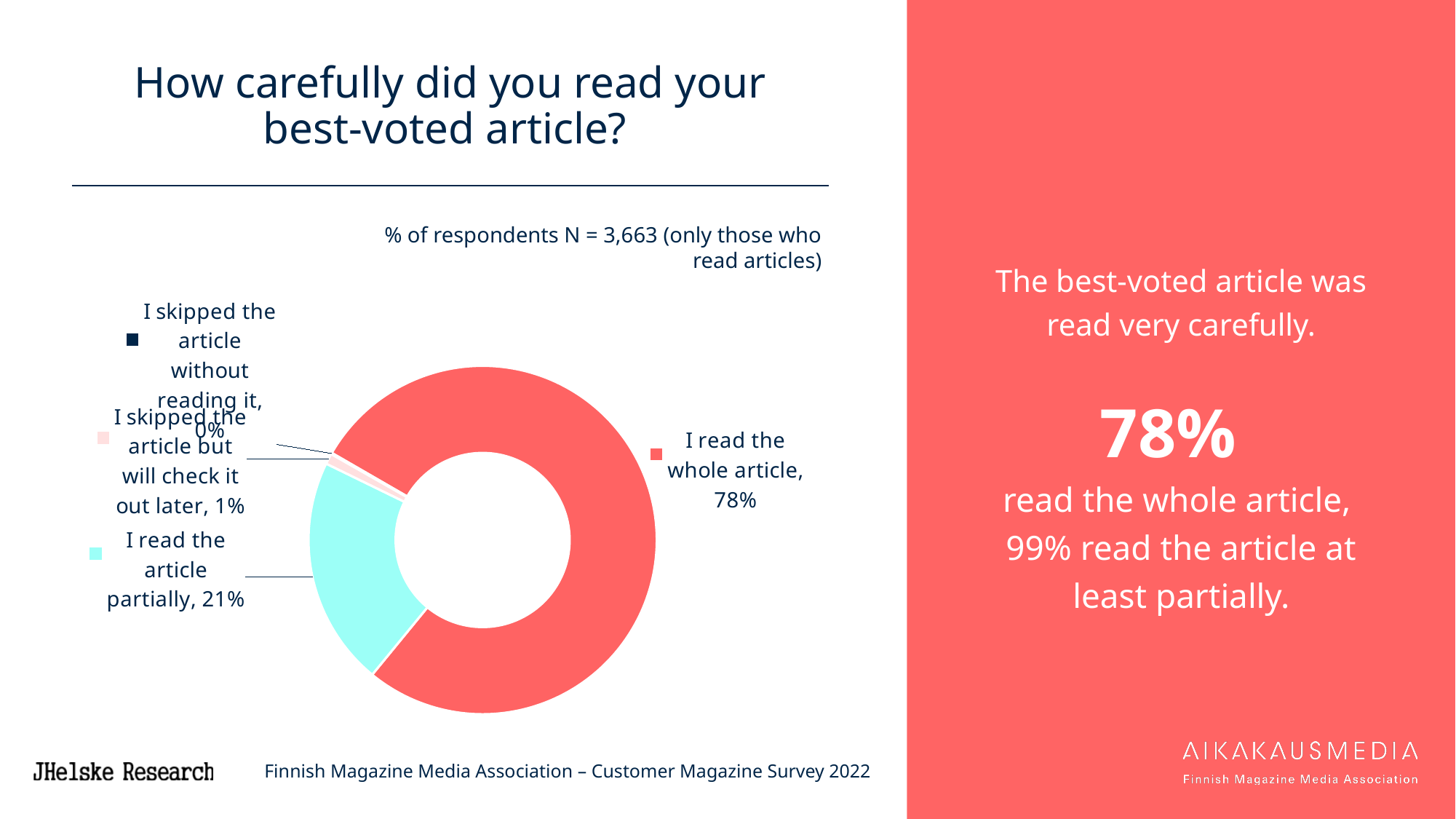
What kind of chart is shown on the slide? Pie chart (donut) Which category has the smallest share of the pie? I skipped the article without reading it What is the sample size (N) stated above the chart? 3,663 Which category has the largest share of the pie? I read the whole article What is the combined share of respondents who read the whole article or read it partially? 99% What percentage of respondents said they skipped the article but will check it out later? 1% Which is larger: the share who read the article partially or the share who skipped it but will check it out later? I read the article partially What percentage of respondents said they skipped the article without reading it? 0% What percentage of respondents said they read the article partially? 21% How many categories does the pie chart show? 4 What is the difference in percentage points between those who read the whole article and those who read it partially? 57 What percentage of respondents said they read the whole article? 78%